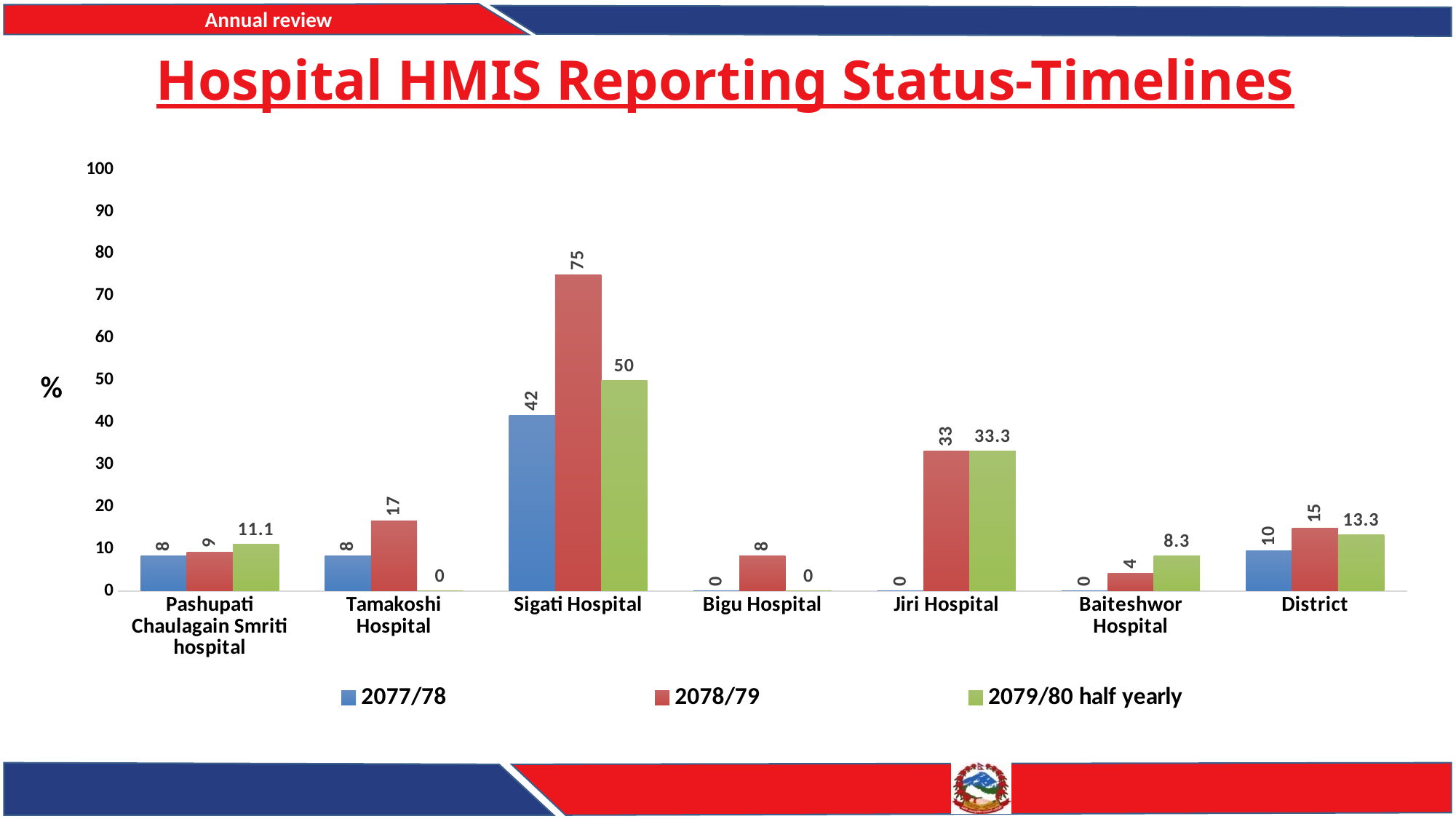
What is the title of the chart? Hospital HMIS Reporting Status-Timelines Is the value for Sigati Hospital in the 2079/80 half yearly series greater or less than 40? greater What is the value for Baiteshwor Hospital in the 2079/80 half yearly series? 8.3 What is the value for Sigati Hospital in the 2078/79 series? 75 What is the value for Jiri Hospital in the 2079/80 half yearly series? 33.3 Which hospital has the highest value in the 2078/79 series? Sigati Hospital What kind of chart is shown on the slide? Bar chart What is the difference between the 2078/79 and 2077/78 values for Sigati Hospital? 33 How many categories are shown on the x axis? 7 What is the value for District in the 2077/78 series? 10 How many series does the legend list? 3 Which is larger for Tamakoshi Hospital: the 2077/78 value or the 2078/79 value? 2078/79